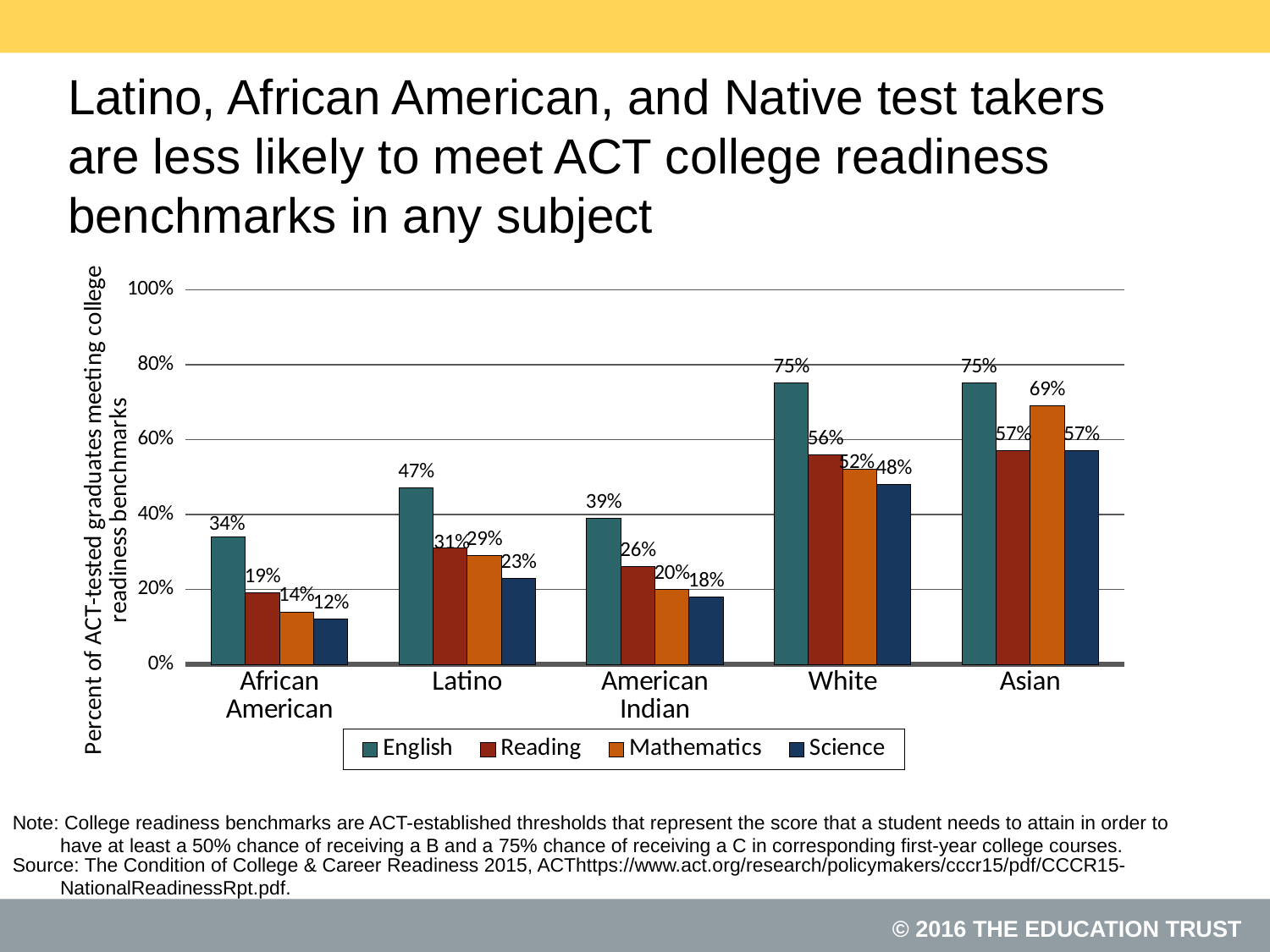
What kind of chart is shown on the slide? bar chart Is the Mathematics value for White test takers greater or less than 40%? greater What is the Science value for Latino test takers? 23% What is the difference between the English values for White and African American test takers? 41% What is the Reading value for White test takers? 56% Which category has the highest Mathematics value? Asian How many categories are shown on the x axis? 5 Which is larger, the Reading value for Latino or the Reading value for American Indian? Latino How many series does the legend list? 4 Which category has the lowest Science value? African American What is the Mathematics value for Asian test takers? 69% What is the English value for African American test takers? 34%